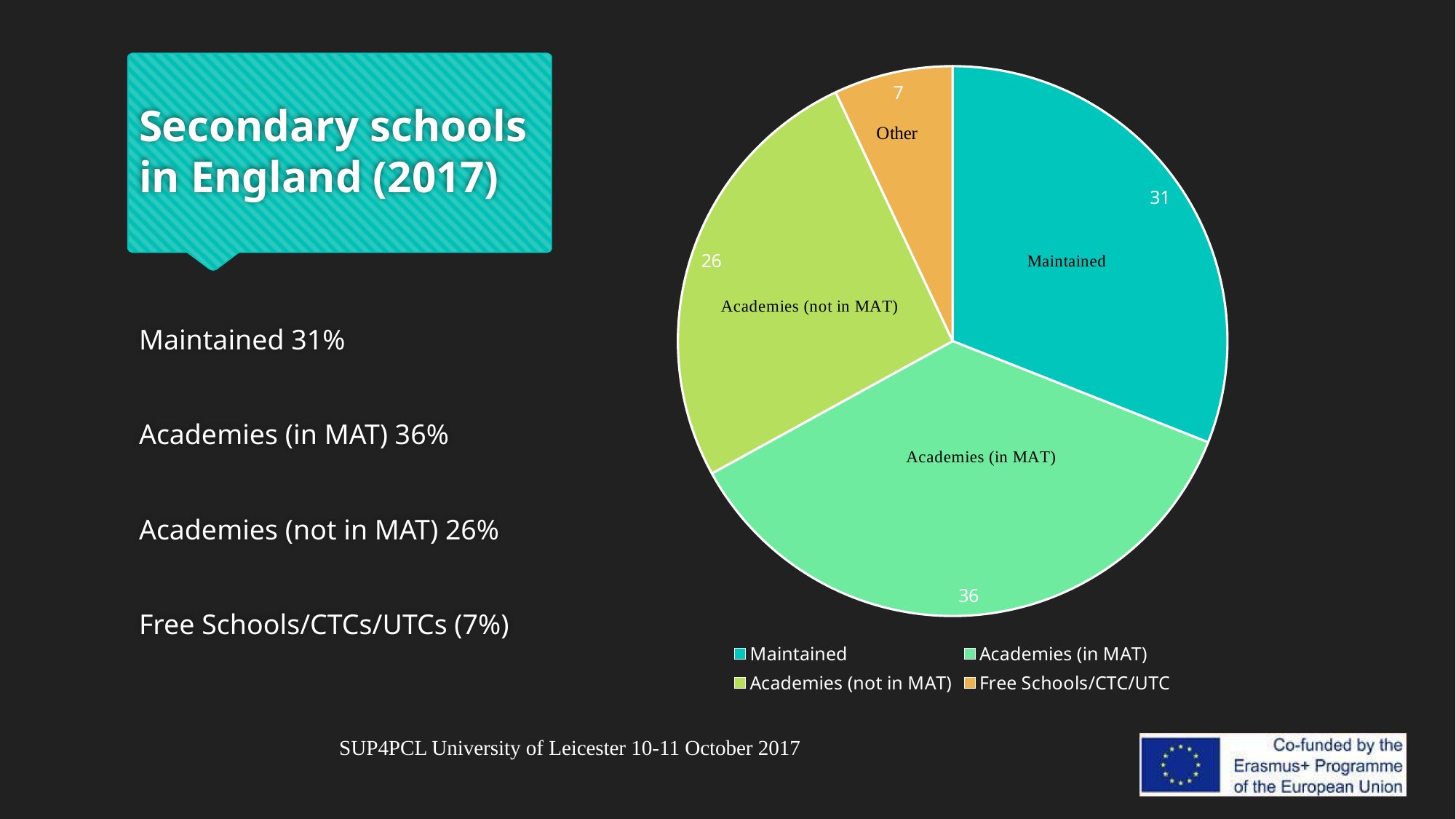
What is the value shown for the Academies (not in MAT) slice? 26 What is the value shown for the Other slice? 7 What is the value shown for the Academies (in MAT) slice? 36 How many entries does the chart legend list? 4 Which slice of the pie chart is the smallest? Other Which slice of the pie chart is the largest? Academies (in MAT) How many slices does the pie chart have? 4 Which is larger, the Maintained slice or the Academies (not in MAT) slice? Maintained What is the difference between the Academies (in MAT) value and the Maintained value? 5 Which legend entry corresponds to the slice labelled Other on the chart? Free Schools/CTC/UTC What type of chart is shown on the slide? Pie chart What is the value shown for the Maintained slice? 31